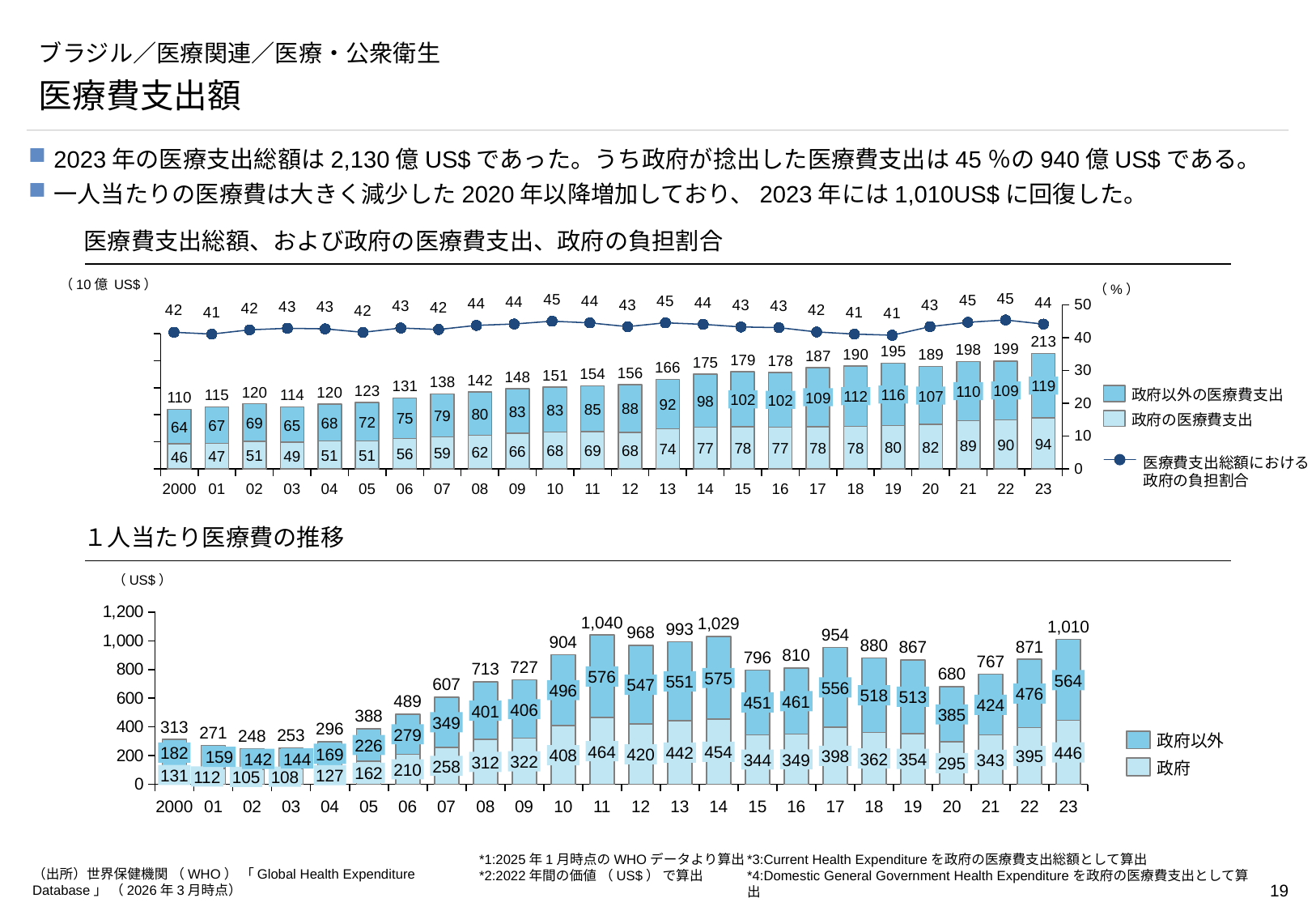
In the bottom chart, what is the value of 政府 for 20? 295 In the top chart, what is the difference between 政府以外の医療費支出 and 政府の医療費支出 for 23? 25 In the top chart, which year has the highest total health expenditure? 23 In the top chart, what is the value of 政府の医療費支出 for 23? 94 In the top chart, which year has the lowest total health expenditure? 2000 In the bottom chart (1人当たり医療費の推移), what is the total per-capita health expenditure for 23? 1,010 In the bottom chart, which year has the highest total per-capita health expenditure? 11 In the top chart, what is the government share (政府の負担割合) for 23? 44 In the top chart (医療費支出総額、および政府の医療費支出、政府の負担割合), what is the total health expenditure for 23? 213 What kind of chart is the bottom chart (1人当たり医療費の推移)? Stacked bar chart In the bottom chart, which year has the lowest total per-capita health expenditure? 02 How many series does the legend of the top chart list? 3